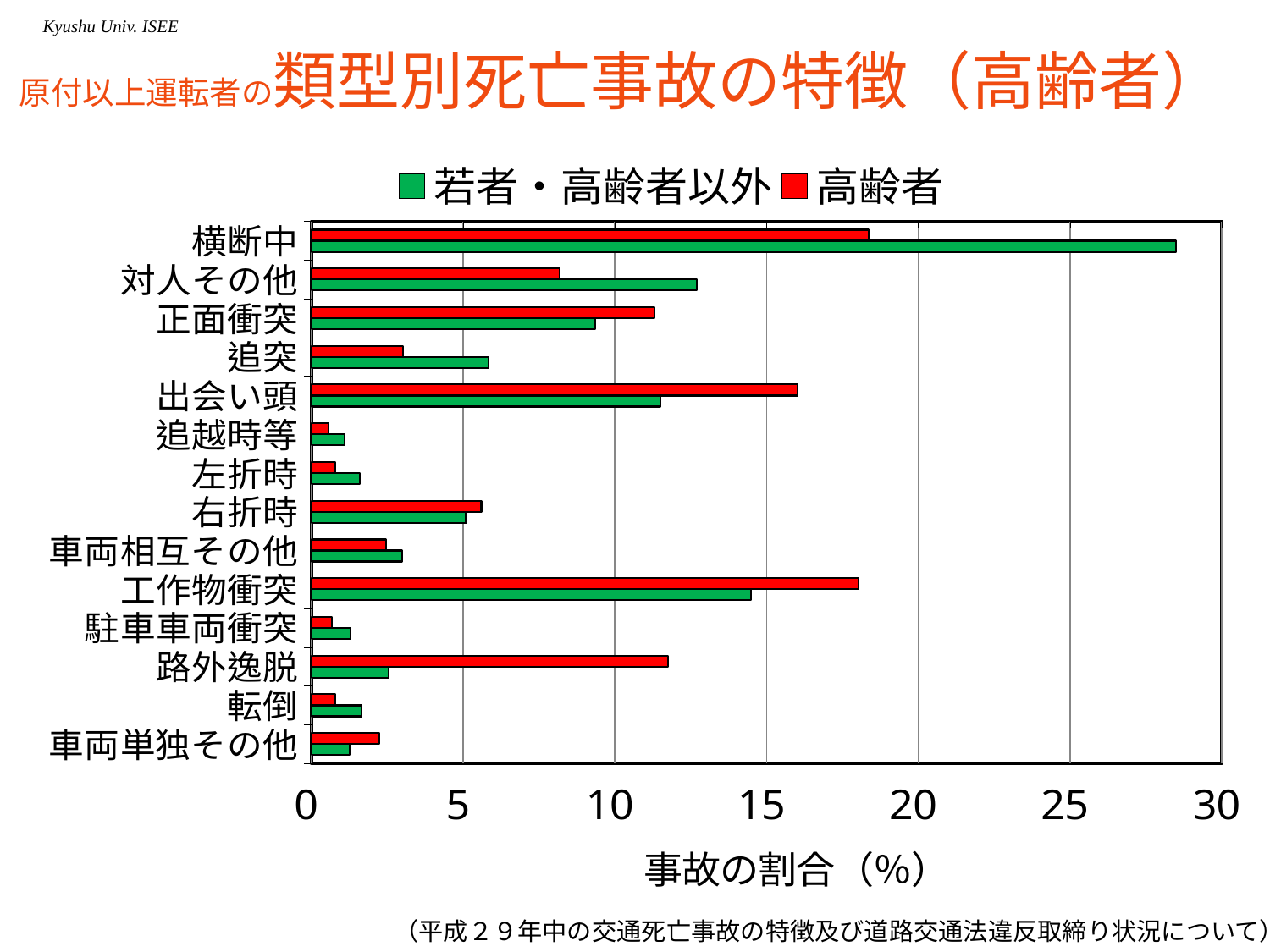
For 路外逸脱, which series has the larger value, 若者・高齢者以外 or 高齢者? 高齢者 Which colour represents the 高齢者 series? red How many series does the legend list? 2 Is the 高齢者 value for 出会い頭 greater or less than 15? greater Is the 高齢者 value for 路外逸脱 greater or less than 10? greater Is the 若者・高齢者以外 value for 路外逸脱 greater or less than 5? less Which category has the highest value for 若者・高齢者以外? 横断中 What is the label of the horizontal axis? 事故の割合（%） For 横断中, which series has the larger value, 若者・高齢者以外 or 高齢者? 若者・高齢者以外 How many accident categories are shown on the vertical axis? 14 What kind of chart is shown on the slide? bar chart